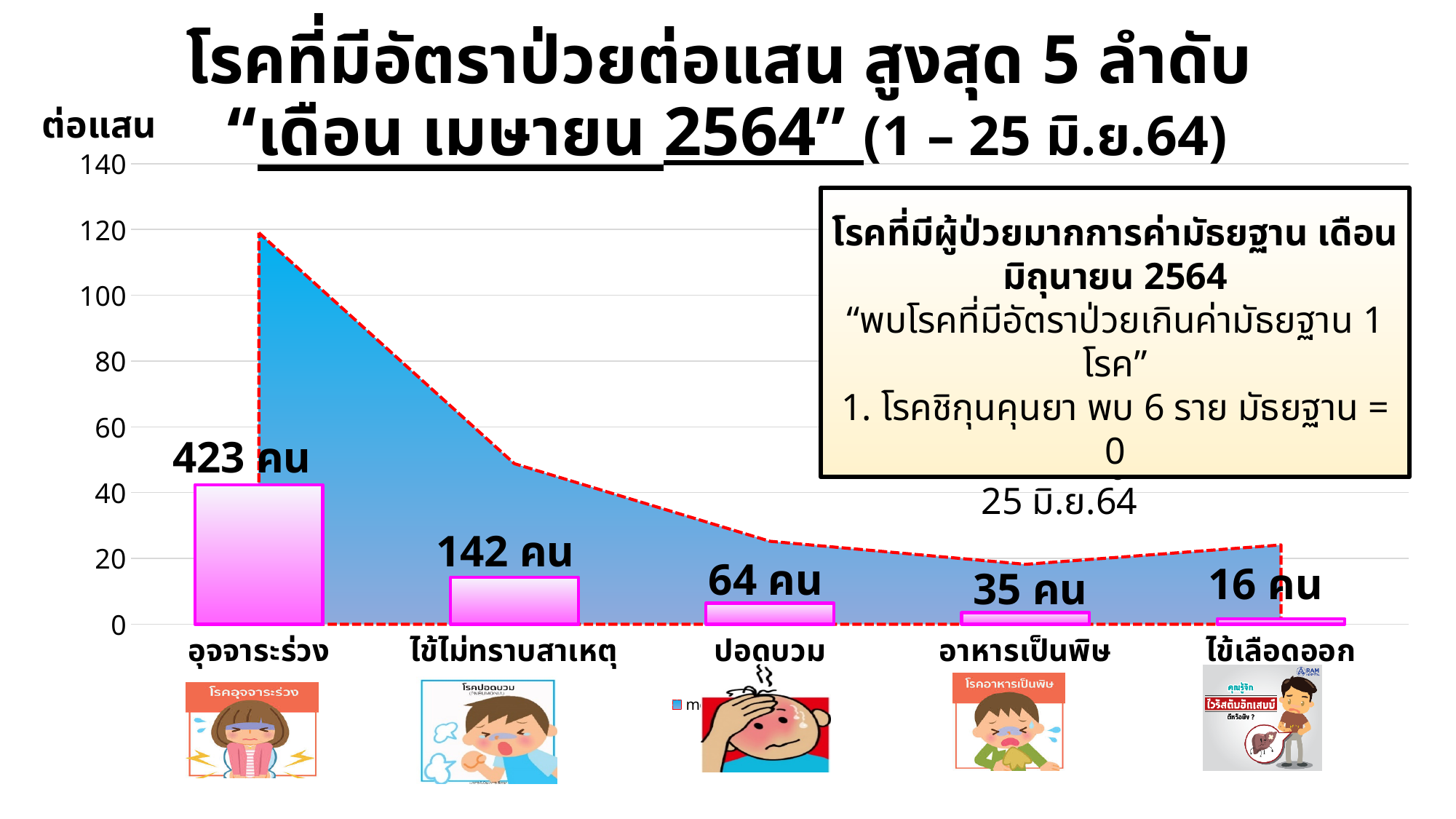
What is the labelled number of cases for ไข้ไม่ทราบสาเหตุ? 142 คน What is the difference between the labelled cases for อุจจาระร่วง and ไข้ไม่ทราบสาเหตุ? 281 คน What is the labelled number of cases for ปอดบวม? 64 คน Is the rate per 100,000 (the area line) for ไข้ไม่ทราบสาเหตุ greater or less than 60? less Is the rate per 100,000 (the area line) for อุจจาระร่วง greater or less than 100? greater Which category has the highest labelled number of cases? อุจจาระร่วง How many disease categories are shown on the x axis? 5 Which has more labelled cases, ปอดบวม or อาหารเป็นพิษ? ปอดบวม Which category has the lowest labelled number of cases? ไข้เลือดออก What is the label on the vertical axis? ต่อแสน What is the labelled number of cases for ไข้เลือดออก? 16 คน What is the labelled number of cases for อุจจาระร่วง? 423 คน